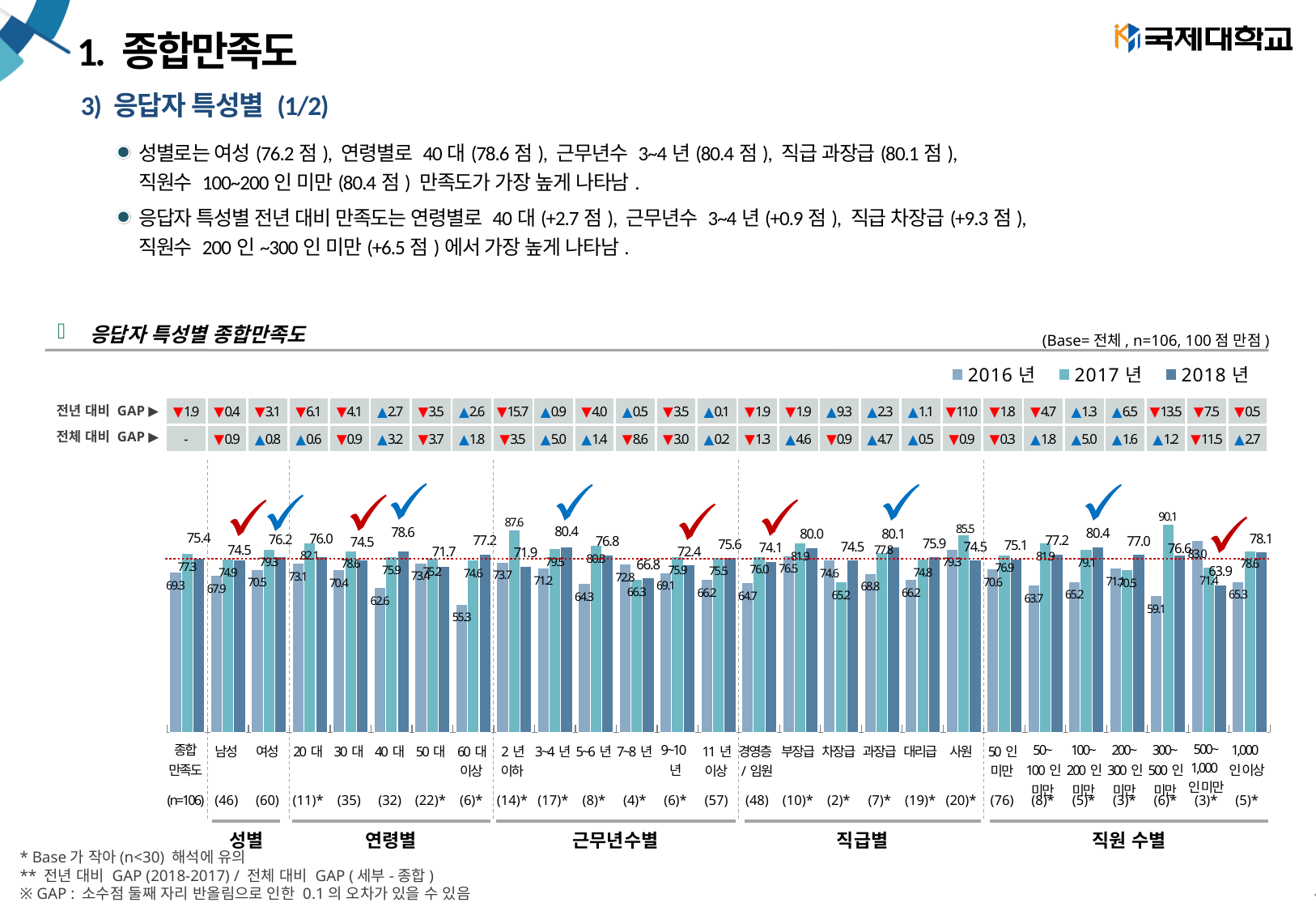
In the 응답자 특성별 종합만족도 chart, what is the 2018년 value for 40대? 78.6 What is the base sample size (n) shown for the 응답자 특성별 종합만족도 chart? n=106 In the 응답자 특성별 종합만족도 chart, what is the difference between the 2017년 and 2016년 values for 종합만족도? 8.0 In the 응답자 특성별 종합만족도 chart, which category has the lowest 2016년 value? 60대 이상 In the 응답자 특성별 종합만족도 chart, what is the 2016년 value for 60대 이상? 55.3 In the 응답자 특성별 종합만족도 chart, which is larger for 과장급: the 2017년 value or the 2018년 value? 2018년 What kind of chart is used to show 응답자 특성별 종합만족도? bar chart In the 응답자 특성별 종합만족도 chart, which category has the highest 2017년 value? 300~500인 미만 In the 응답자 특성별 종합만족도 chart, what is the 2018년 value for 여성? 76.2 In the 응답자 특성별 종합만족도 chart, what is the 2017년 value for 2년 이하? 87.6 How many series does the legend of the 응답자 특성별 종합만족도 chart list? 3 In the 응답자 특성별 종합만족도 chart, what is the 2018년 value for 500~1,000인 미만? 63.9